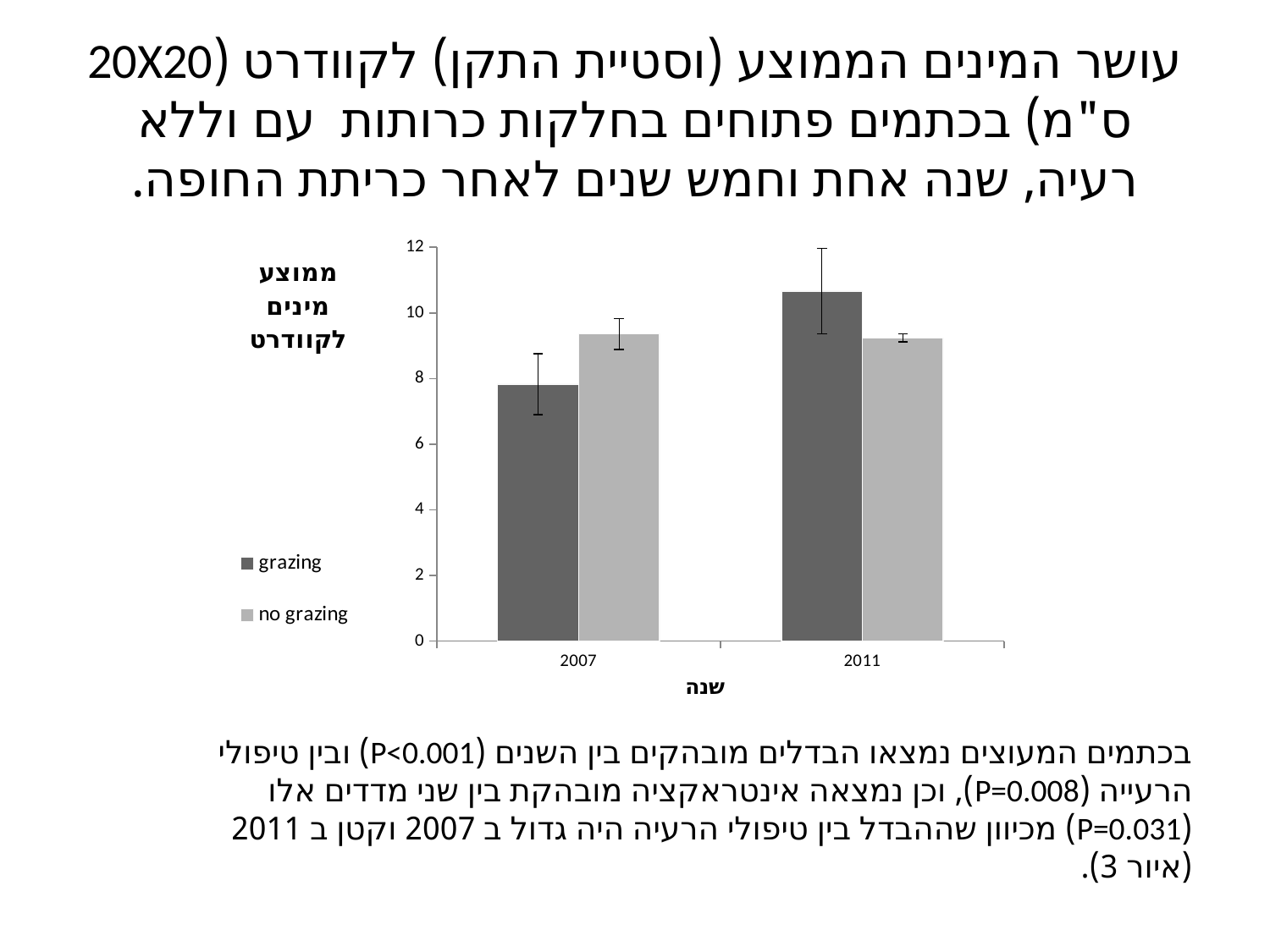
What kind of chart is shown on the slide? bar chart Which bar is the highest in the chart? grazing in 2011 In 2011, which is larger: the grazing bar or the no grazing bar? grazing Does the grazing series rise or fall from 2007 to 2011? rise What are the two series named in the legend? grazing, no grazing Is the value for no grazing in 2007 greater or less than 10? less Which bar is the lowest in the chart? grazing in 2007 Which series is drawn in the darker grey bars? grazing How many year categories are shown on the x axis? 2 Is the value for grazing in 2011 greater or less than 10? greater How many series does the legend list? 2 In 2007, which is larger: the grazing bar or the no grazing bar? no grazing